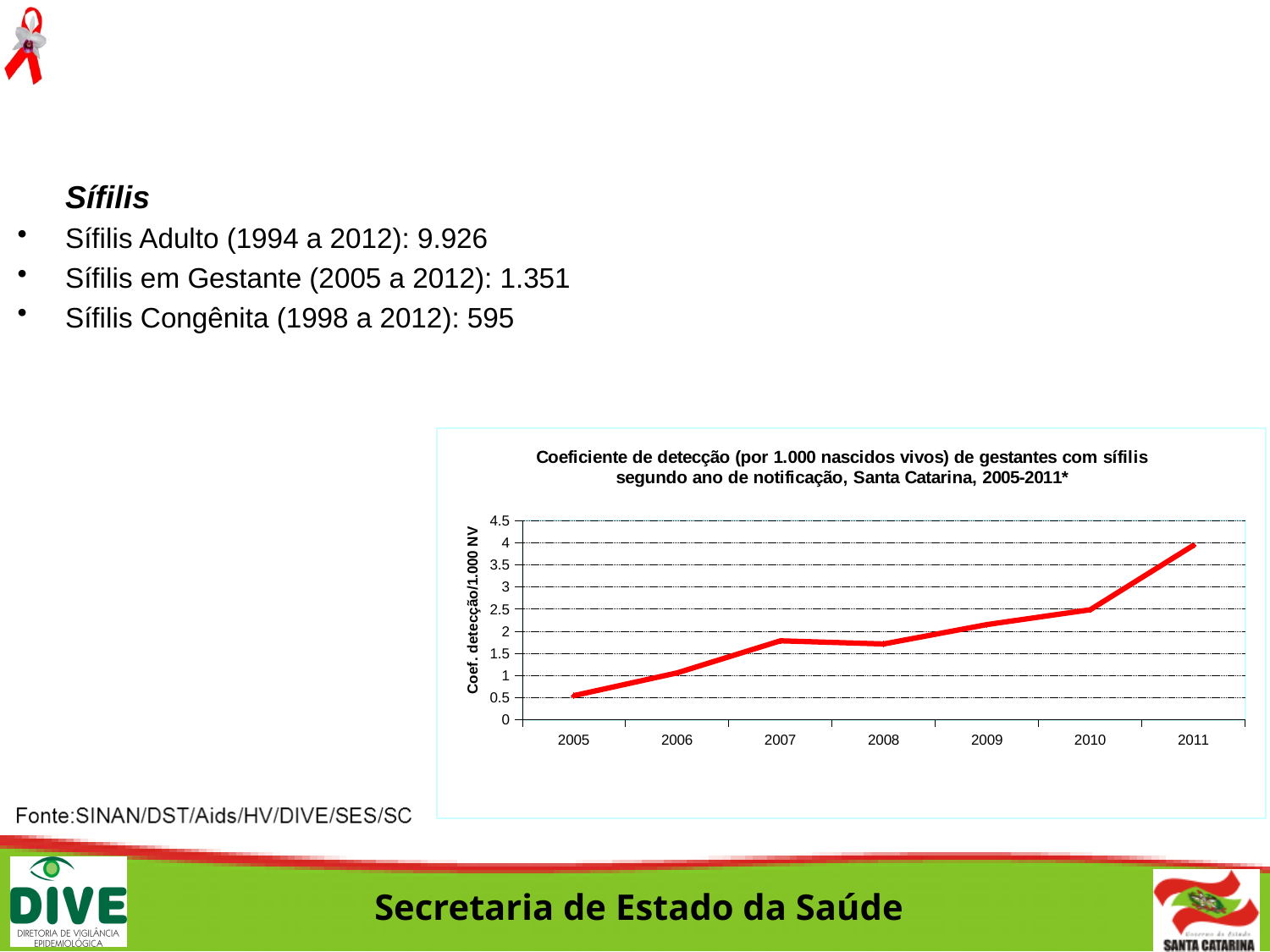
Which year has the highest detection coefficient in the chart? 2011 Do the values in the chart generally rise or fall from 2005 to 2011? rise Is the value for 2005 greater or less than 1? less How many years are plotted on the x axis of the chart? 7 What is the label of the y axis of the chart? Coef. detecção/1.000 NV Which year has a higher value, 2010 or 2011? 2011 Is the value for 2008 greater or less than 2? less What kind of chart is shown on the slide? line chart Which year has the lowest detection coefficient in the chart? 2005 Is the value for 2010 greater or less than 2? greater What colour is the line in the chart? red